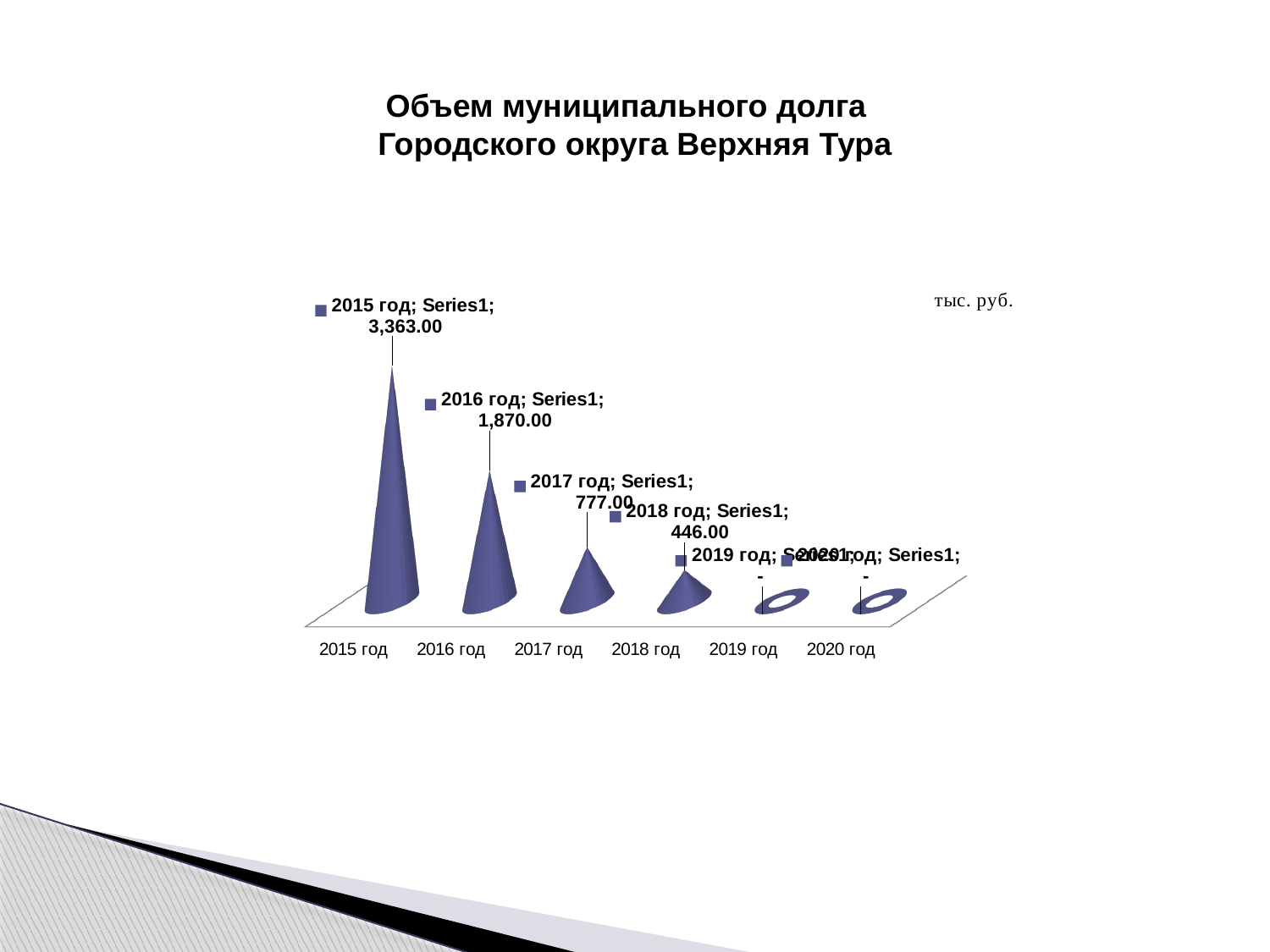
What is the difference between the values for 2015 год and 2016 год? 1,493.00 What unit is indicated for the chart values? тыс. руб. Do the values rise or fall from 2015 год to 2018 год? fall What is the value for 2018 год? 446.00 Which year has the highest value? 2015 год What is the title of the chart? Объем муниципального долга Городского округа Верхняя Тура What is the difference between the values for 2017 год and 2018 год? 331.00 What is the value for 2017 год? 777.00 What is the value for 2015 год? 3,363.00 How many year categories are shown on the x axis? 6 What is the value for 2016 год? 1,870.00 Which is larger, the value for 2016 год or the value for 2017 год? 2016 год